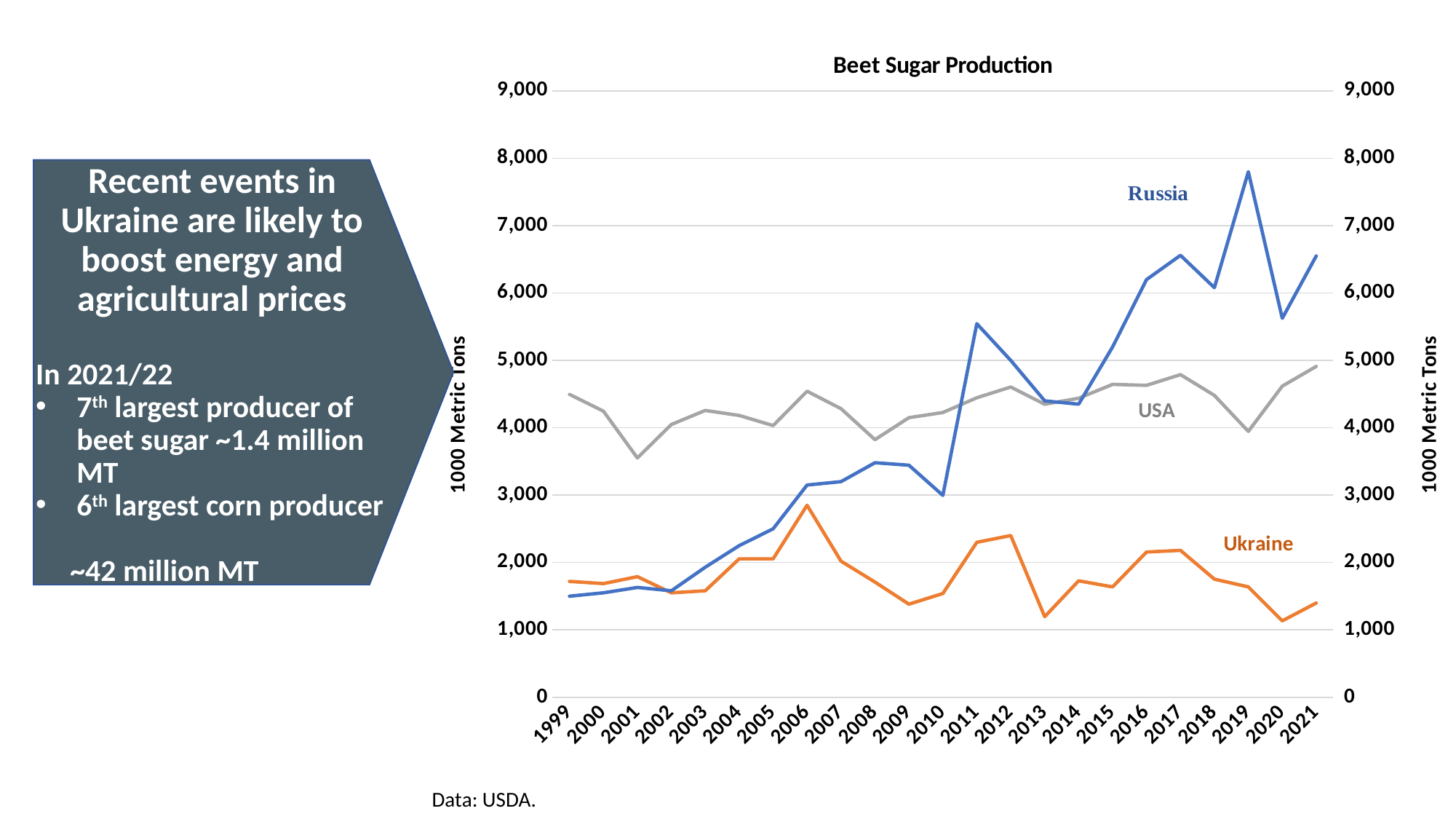
In which year does the Russia line reach its highest value? 2019 How many series (countries) are plotted on the chart? 3 Which country has the lowest beet sugar production in 2021? Ukraine Is the value for Russia in 2019 greater or less than 7,000? greater Is the value for Ukraine in 2013 greater or less than 2,000? less In which year does the Ukraine line reach its highest value? 2006 What is the label on the vertical axis of the chart? 1000 Metric Tons In 2010, which is larger: the value for USA or the value for Russia? USA What kind of chart is shown on the slide? line chart What is the title of the chart? Beet Sugar Production Which country has the highest beet sugar production in 2021? Russia How many years are shown along the x axis of the chart? 23